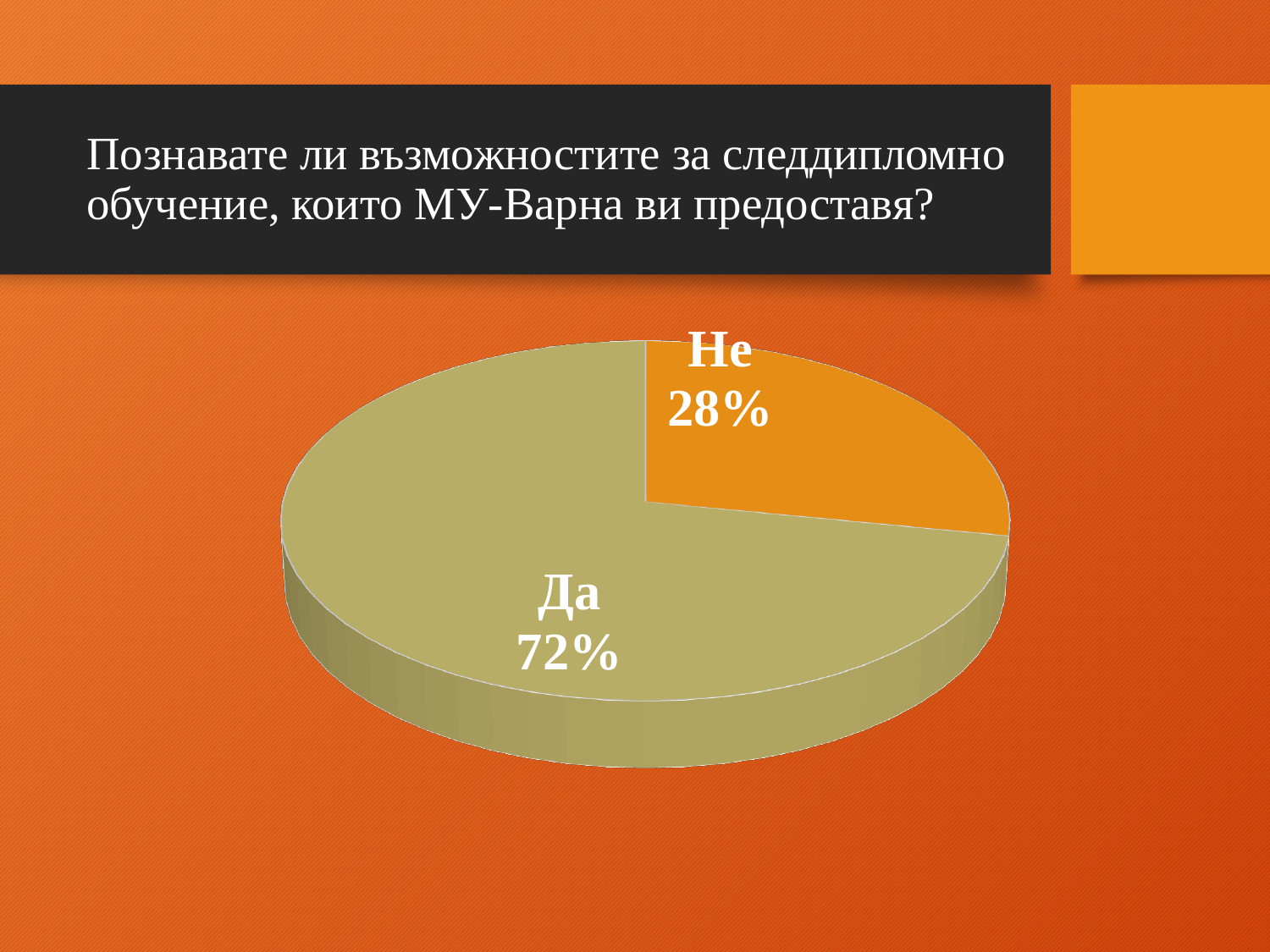
What share of the pie does the "Не" slice represent? 28% What share of the pie does the "Да" slice represent? 72% Is the share for "Не" greater or less than 50%? less Which slice of the pie is the smallest? Не Which slice of the pie is the largest? Да What is the difference in percentage points between the "Да" and "Не" slices? 44 What colour is the "Не" slice of the pie? orange What kind of chart is shown on the slide? pie chart Which is larger, the "Да" slice or the "Не" slice? Да What question does the slide title ask about the chart? Познавате ли възможностите за следдипломно обучение, които МУ-Варна ви предоставя? How many slices does the pie chart have? 2